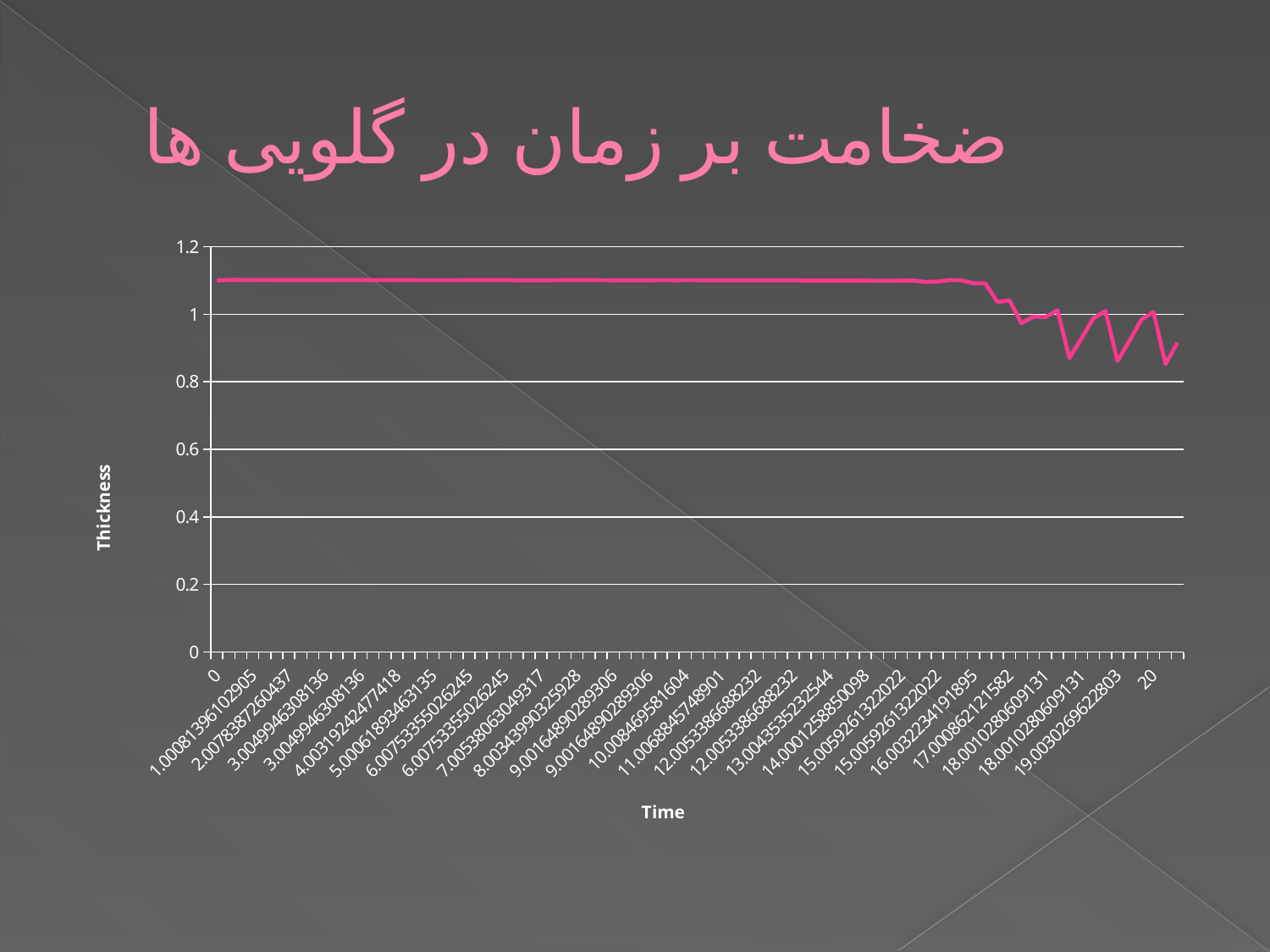
What is the highest tick value shown on the y axis? 1.2 Is the value for Time 5.00061893463135 greater or less than 1.2? less What is the title of the y axis? Thickness Is the value for Time 10.0084695816604 greater or less than 0.8? greater Is the value for Time 0 greater or less than 1? greater Do the values overall rise or fall along the x axis? fall What kind of chart is shown on the slide? line chart What is the title of the x axis? Time Which is larger, the value at Time 0 or the value at Time 20? Time 0